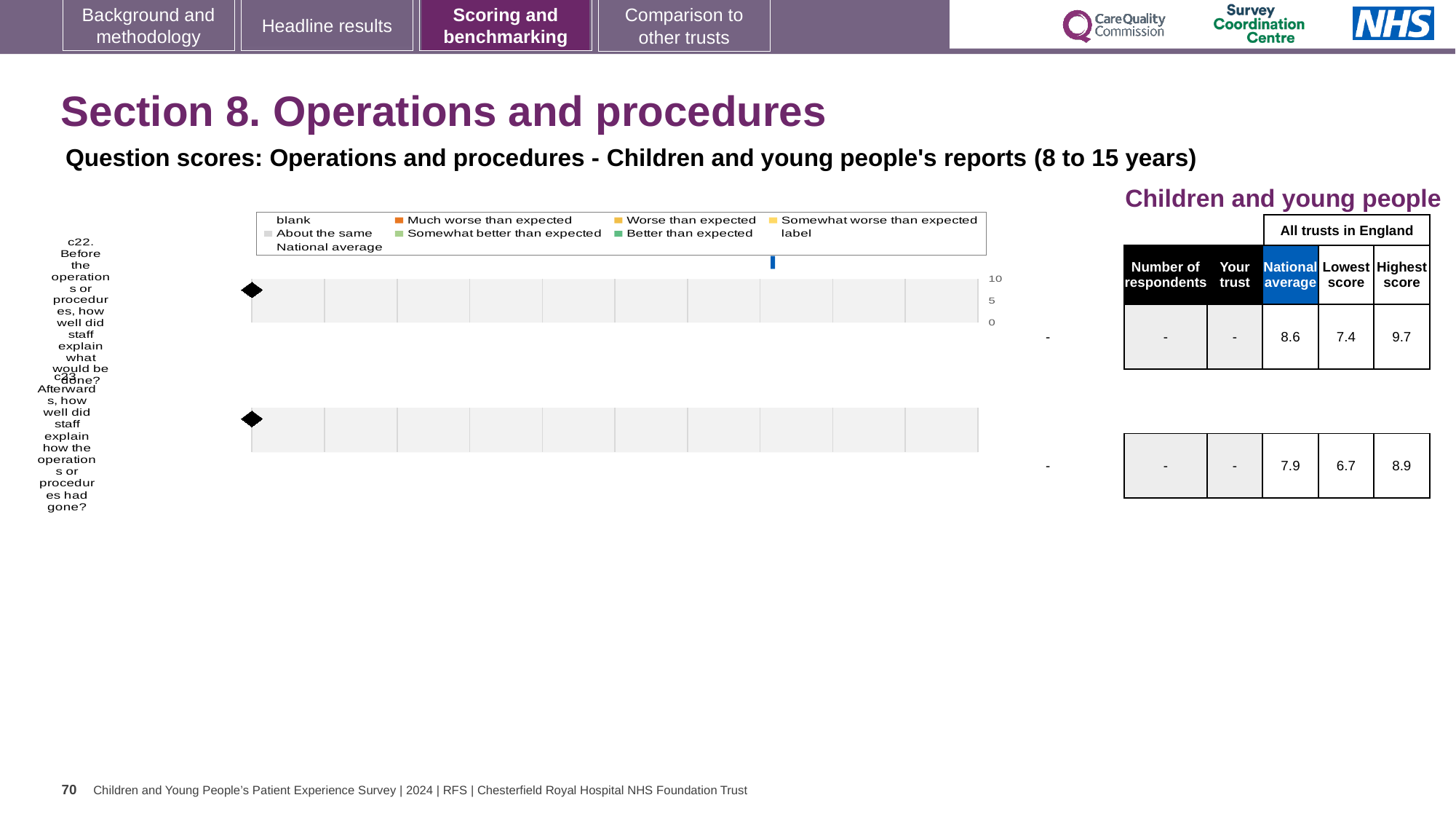
In the table to the right of the chart, what is the difference between the highest and lowest score for c23? 2.2 In the table to the right of the chart, what is the national average for c22 (Before the operations or procedures, how well did staff explain what would be done?)? 8.6 In the table to the right of the chart, what is the highest score for c22? 9.7 What is the highest value shown on the chart's numeric axis? 10 In the table to the right of the chart, what is the national average for c23 (Afterwards, how well did staff explain how the operations or procedures had gone?)? 7.9 In the table to the right of the chart, which question has the higher national average, c22 or c23? c22 What kind of chart is shown on the slide? bar chart In the table to the right of the chart, what is the lowest score for c23? 6.7 Which legend entry is shown with an orange marker? Much worse than expected How many question categories are listed on the chart's vertical axis? 2 In the table to the right of the chart, what value is shown for 'Your trust' for c22? -